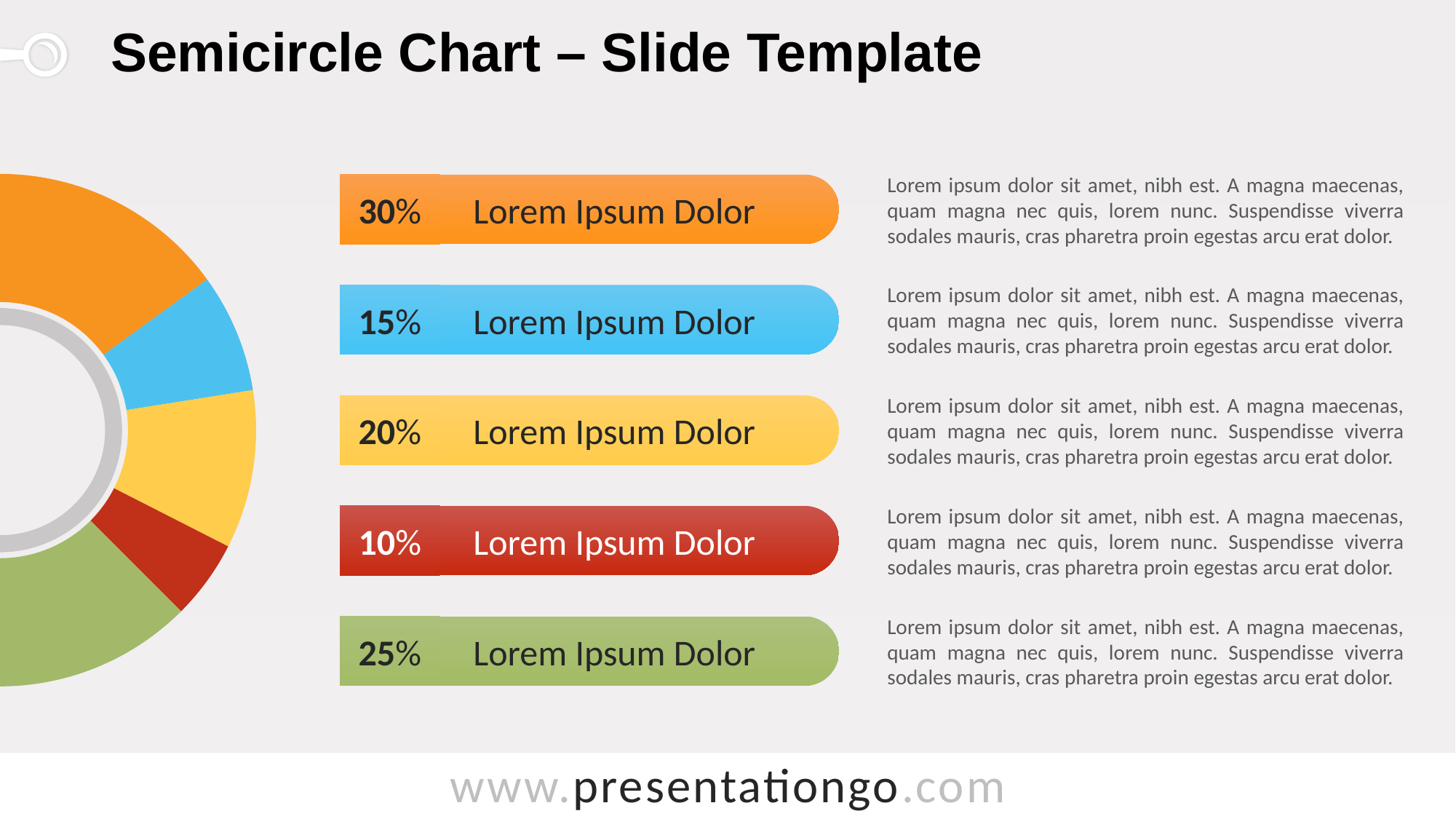
What do the five segment percentages add up to? 100% How many segments does the semicircle chart have? 5 What percentage is shown for the orange segment of the semicircle chart? 30% What is the title of the slide? Semicircle Chart – Slide Template What percentage is shown for the yellow segment of the semicircle chart? 20% Which is larger, the green segment or the yellow segment? Green What is the difference between the orange segment's percentage and the red segment's percentage? 20% What percentage is shown for the green segment of the semicircle chart? 25% Which colour segment has the highest percentage in the semicircle chart? Orange What percentage is shown for the red segment of the semicircle chart? 10% Which colour segment has the lowest percentage in the semicircle chart? Red What percentage is shown for the blue segment of the semicircle chart? 15%